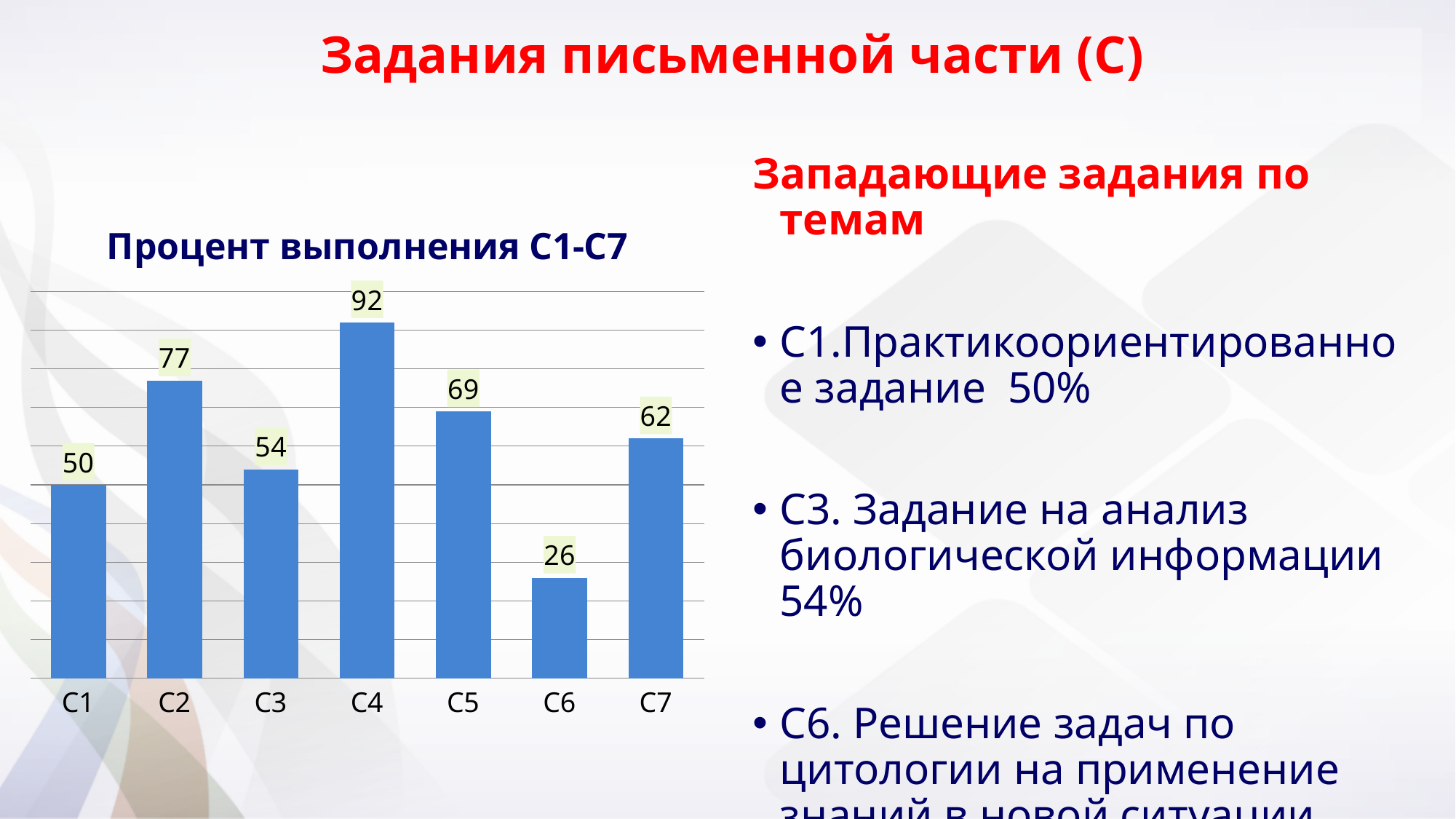
What is the value for C4 in the chart 'Процент выполнения С1-С7'? 92 Which is larger, the value for C5 or the value for C7? C5 What is the difference between the values for C4 and C6? 66 What is the value for C2 in the chart? 77 What kind of chart is shown on the slide? bar chart Which category has the highest value in the chart? C4 What is the value for C6 in the chart? 26 Which category has the lowest value in the chart? C6 How many categories are shown in the chart? 7 What is the title of the chart? Процент выполнения С1-С7 What colour are the bars in the chart? blue What is the difference between the values for C2 and C1? 27